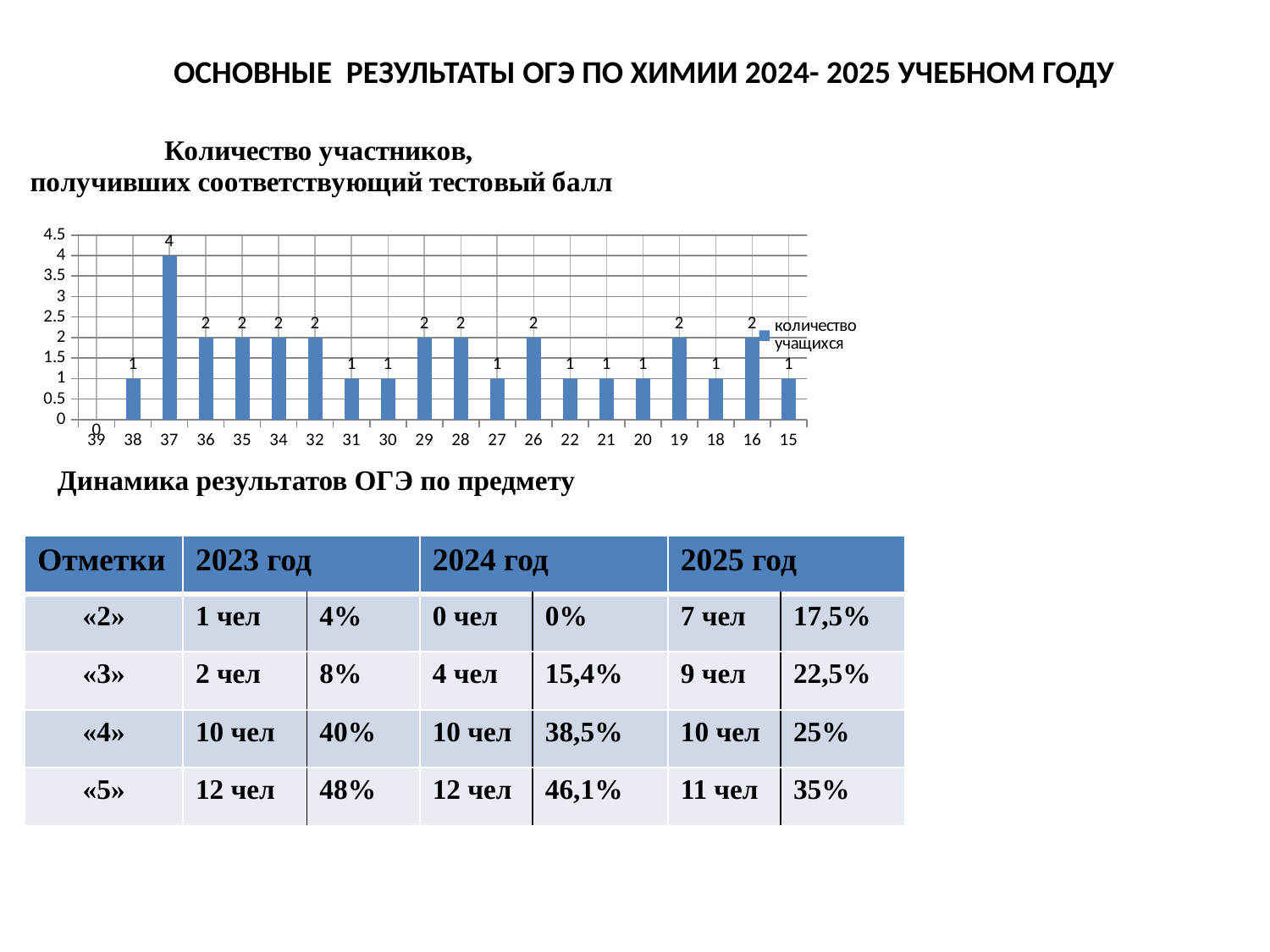
How many test score categories are shown on the x axis? 20 How many participants received a test score of 38? 1 Which test score has the lowest number of participants? 39 How many participants received a test score of 26? 2 What is the difference between the number of participants with score 37 and with score 36? 2 What type of chart is shown on the slide? bar chart How many participants received a test score of 39? 0 How many series does the legend list? 1 What is the legend entry of the chart? количество учащихся Which has more participants: score 29 or score 27? 29 How many participants received a test score of 37? 4 Which test score has the highest number of participants? 37